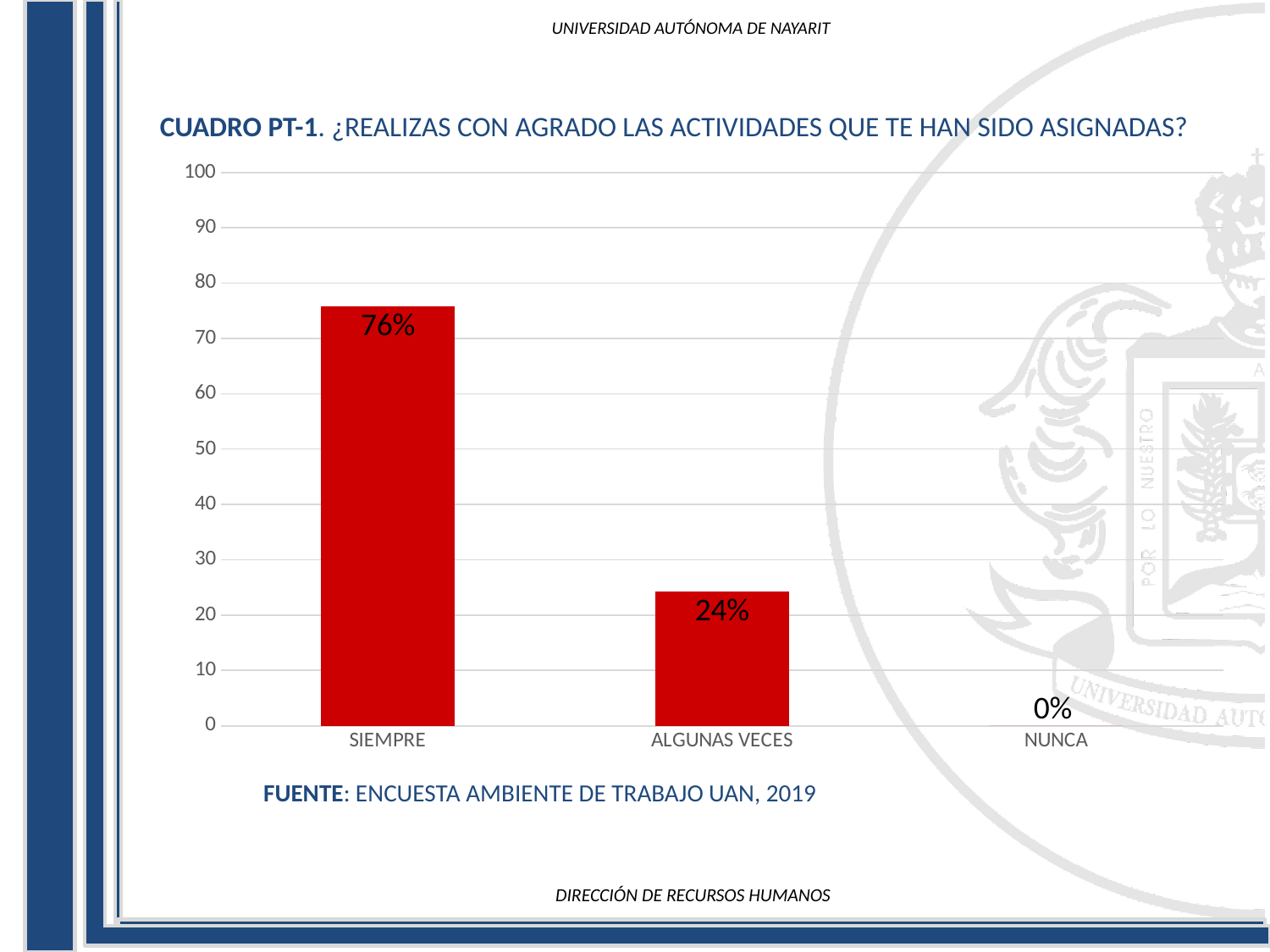
What is the difference between the values for SIEMPRE and ALGUNAS VECES? 52% Do the values rise or fall from left to right along the x axis? fall Which category has the lowest value? NUNCA How many categories are shown on the x axis? 3 What kind of chart is shown on the slide? bar chart Is the value for SIEMPRE greater or less than 70? greater Which category has the highest value? SIEMPRE Which is larger, the value for ALGUNAS VECES or the value for NUNCA? ALGUNAS VECES What source is cited below the chart? ENCUESTA AMBIENTE DE TRABAJO UAN, 2019 What is the value for ALGUNAS VECES? 24% What is the value for NUNCA? 0% What is the value for SIEMPRE? 76%